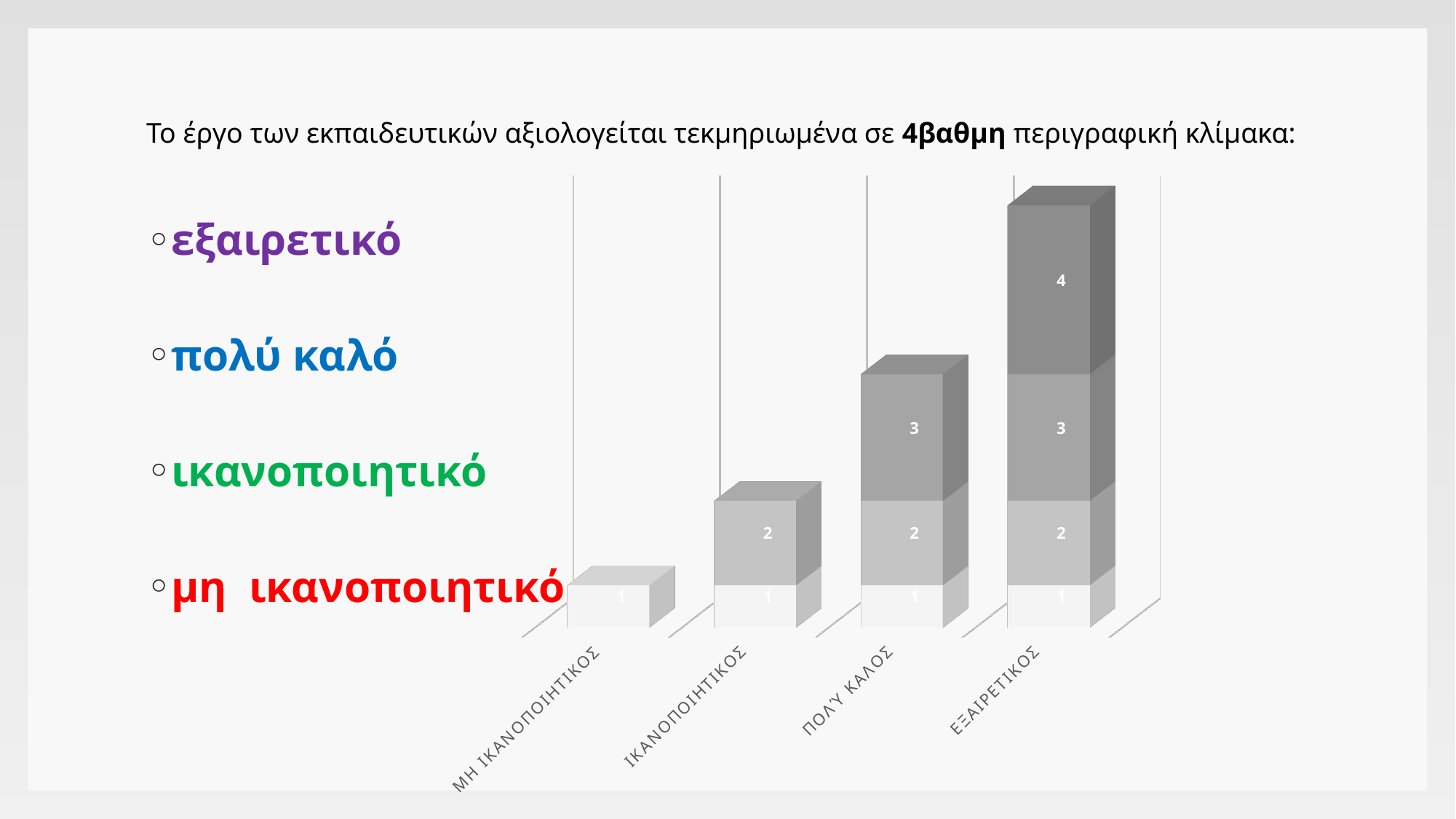
What is the value of the top segment of the ΠΟΛΎ ΚΑΛΟΣ bar? 3 What is the total of the stacked segments in the ΕΞΑΙΡΕΤΙΚΟΣ bar? 10 How many categories are shown on the x axis of the chart? 4 What is the total of the stacked segments in the ΠΟΛΎ ΚΑΛΟΣ bar? 6 Do the bar heights rise or fall from left to right along the x axis? rise What kind of chart is shown on the slide? stacked bar chart Which category has the shortest bar in the chart? ΜΗ ΙΚΑΝΟΠΟΙΗΤΙΚΟΣ Which bar is taller, ΙΚΑΝΟΠΟΙΗΤΙΚΟΣ or ΠΟΛΎ ΚΑΛΟΣ? ΠΟΛΎ ΚΑΛΟΣ Which category has the tallest bar in the chart? ΕΞΑΙΡΕΤΙΚΟΣ What is the value of the top segment of the ΕΞΑΙΡΕΤΙΚΟΣ bar? 4 How many stacked segments does the ΕΞΑΙΡΕΤΙΚΟΣ bar have? 4 What is the total of the stacked segments in the ΙΚΑΝΟΠΟΙΗΤΙΚΟΣ bar? 3